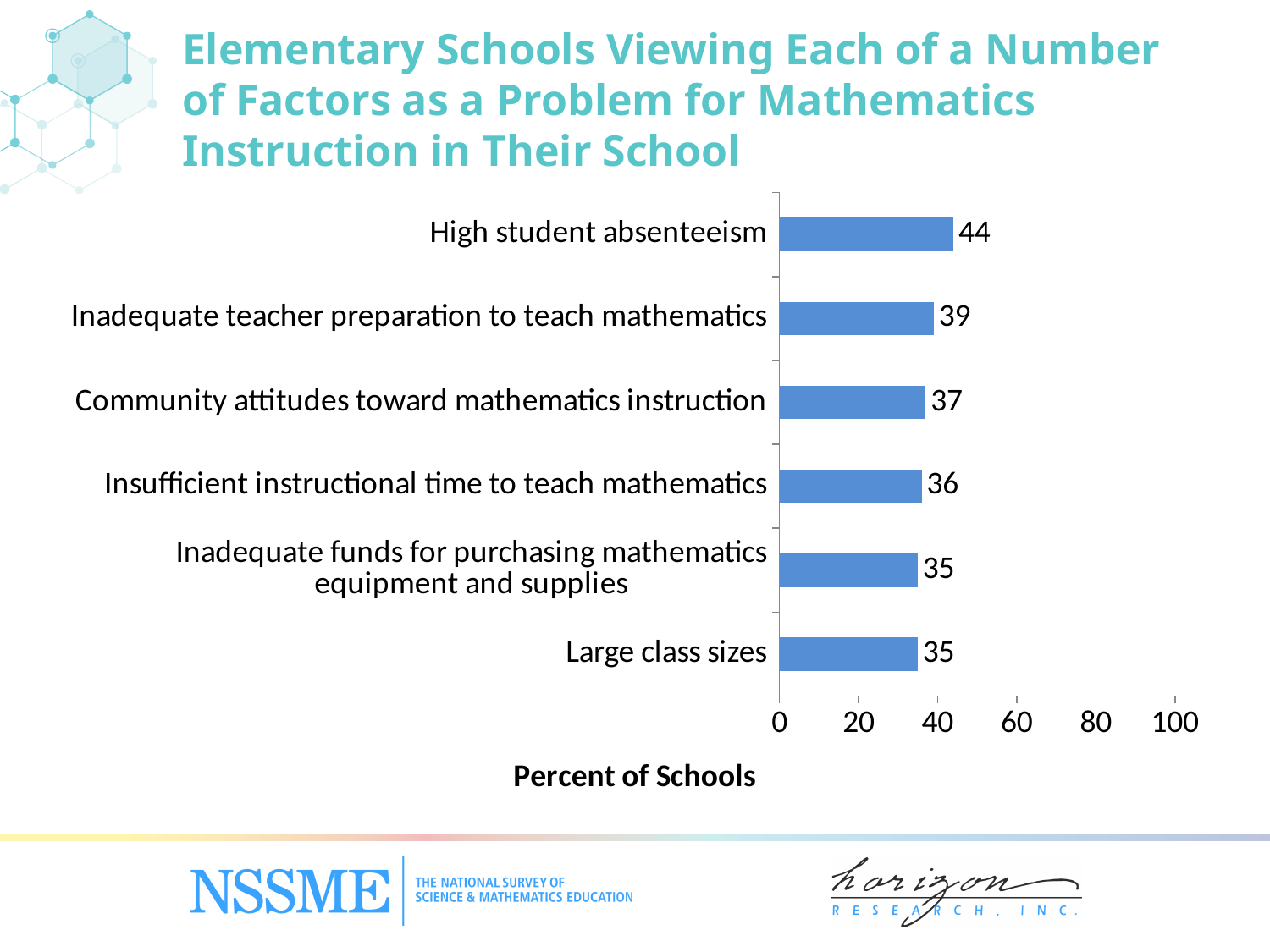
What is the difference between the values for 'High student absenteeism' and 'Large class sizes'? 9 What is the value for 'Large class sizes'? 35 What percent of schools view high student absenteeism as a problem for mathematics instruction? 44 What is the value for 'Community attitudes toward mathematics instruction'? 37 What is the difference between the values for 'Inadequate teacher preparation to teach mathematics' and 'Insufficient instructional time to teach mathematics'? 3 How many factors are shown in the chart? 6 Which factor has the highest percent of schools viewing it as a problem? High student absenteeism Which is larger: the value for 'High student absenteeism' or the value for 'Community attitudes toward mathematics instruction'? High student absenteeism Is the value for 'High student absenteeism' greater or less than 40? greater What kind of chart is shown on the slide? Bar chart What is the label of the horizontal axis? Percent of Schools What is the value for 'Inadequate teacher preparation to teach mathematics'? 39